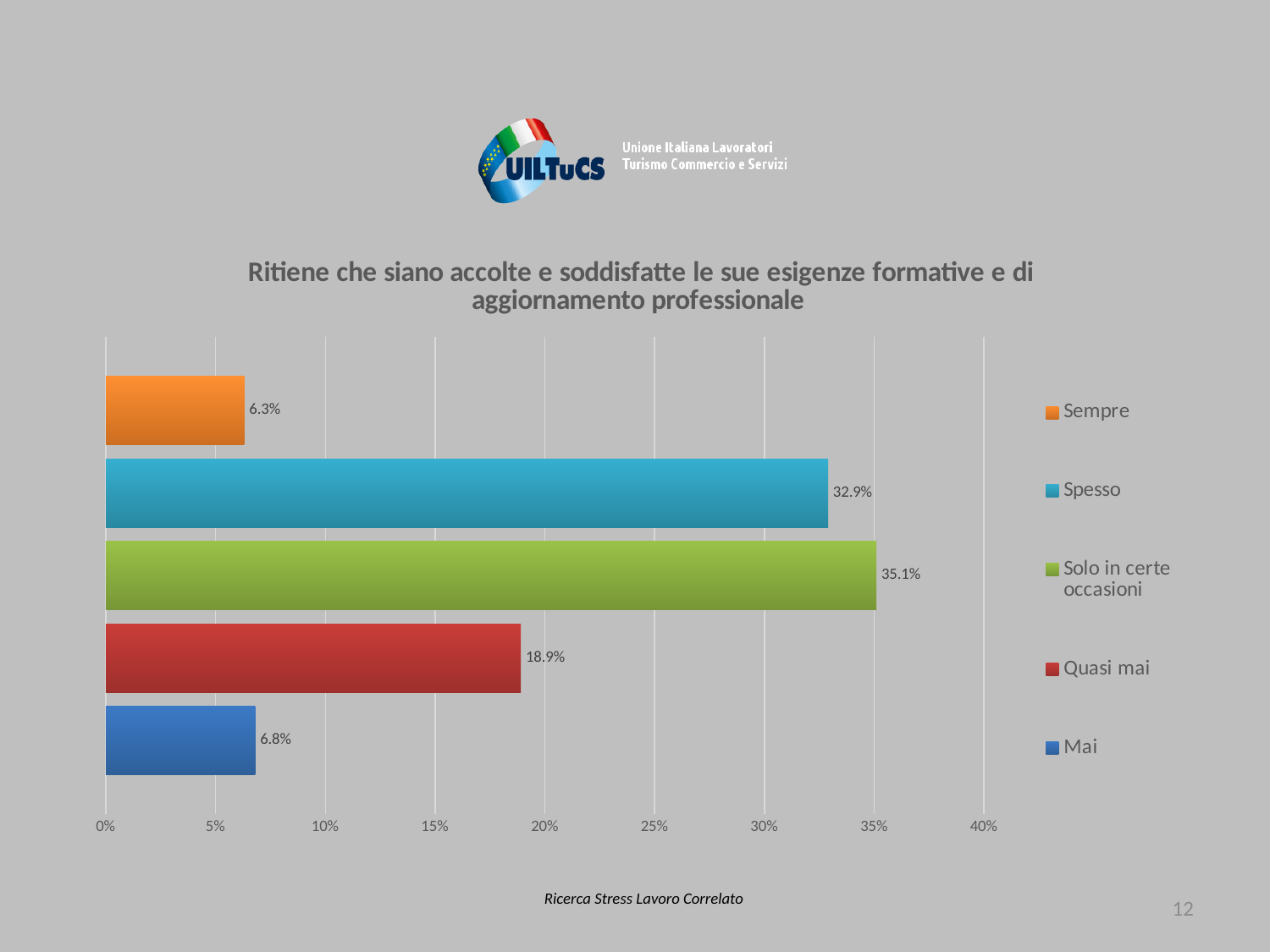
Which response category has the highest percentage? Solo in certe occasioni Which is larger, the value for "Mai" or the value for "Sempre"? Mai What percentage of respondents answered "Spesso"? 32.9% What is the value shown for "Solo in certe occasioni"? 35.1% What colour is the bar for "Quasi mai"? Red How many response categories are shown in the chart? 5 What type of chart is shown on the slide? Bar chart What is the value for "Mai"? 6.8% What is the difference in percentage points between "Solo in certe occasioni" and "Spesso"? 2.2 percentage points Which response category has the lowest percentage? Sempre What is the difference between the values for "Quasi mai" and "Mai"? 12.1 percentage points What percentage is shown for "Quasi mai"? 18.9%